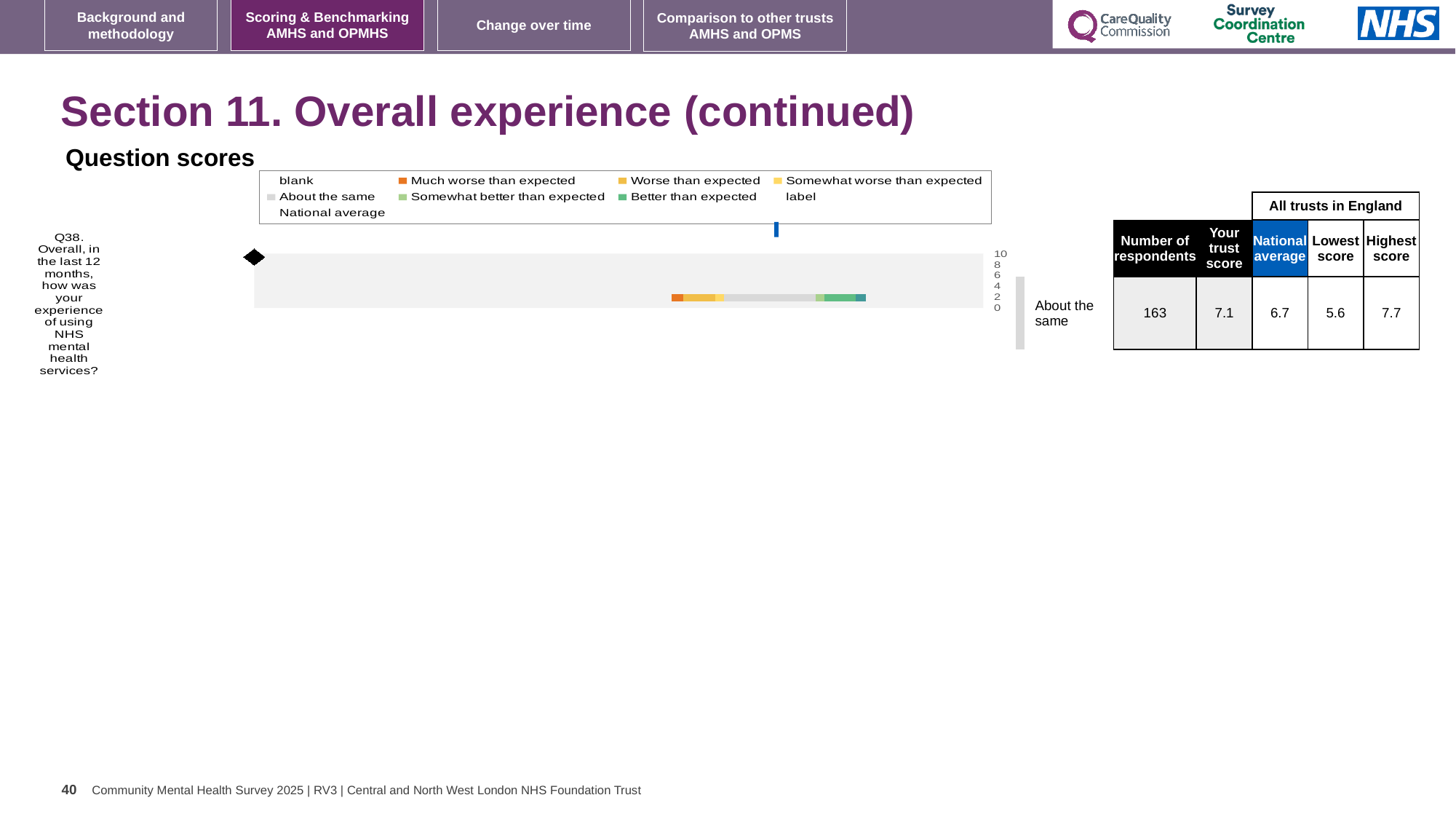
Which question is plotted in the Question scores chart? Q38. Overall, in the last 12 months, how was your experience of using NHS mental health services? How many entries does the legend of the Question scores chart list? 9 What kind of chart is shown under 'Question scores'? bar chart What is the trust score for Q38 shown in the table beside the chart? 7.1 What benchmark category label is shown to the right of the bar for Q38? About the same What is the lowest score among all trusts in England for Q38? 5.6 What is the national average for Q38 shown in the table beside the chart? 6.7 How many respondents answered Q38? 163 For Q38, is the trust score or the national average higher? trust score What is the highest score among all trusts in England for Q38? 7.7 For Q38, what is the difference between the highest score and the lowest score among all trusts in England? 2.1 How many questions are plotted in the Question scores chart? 1